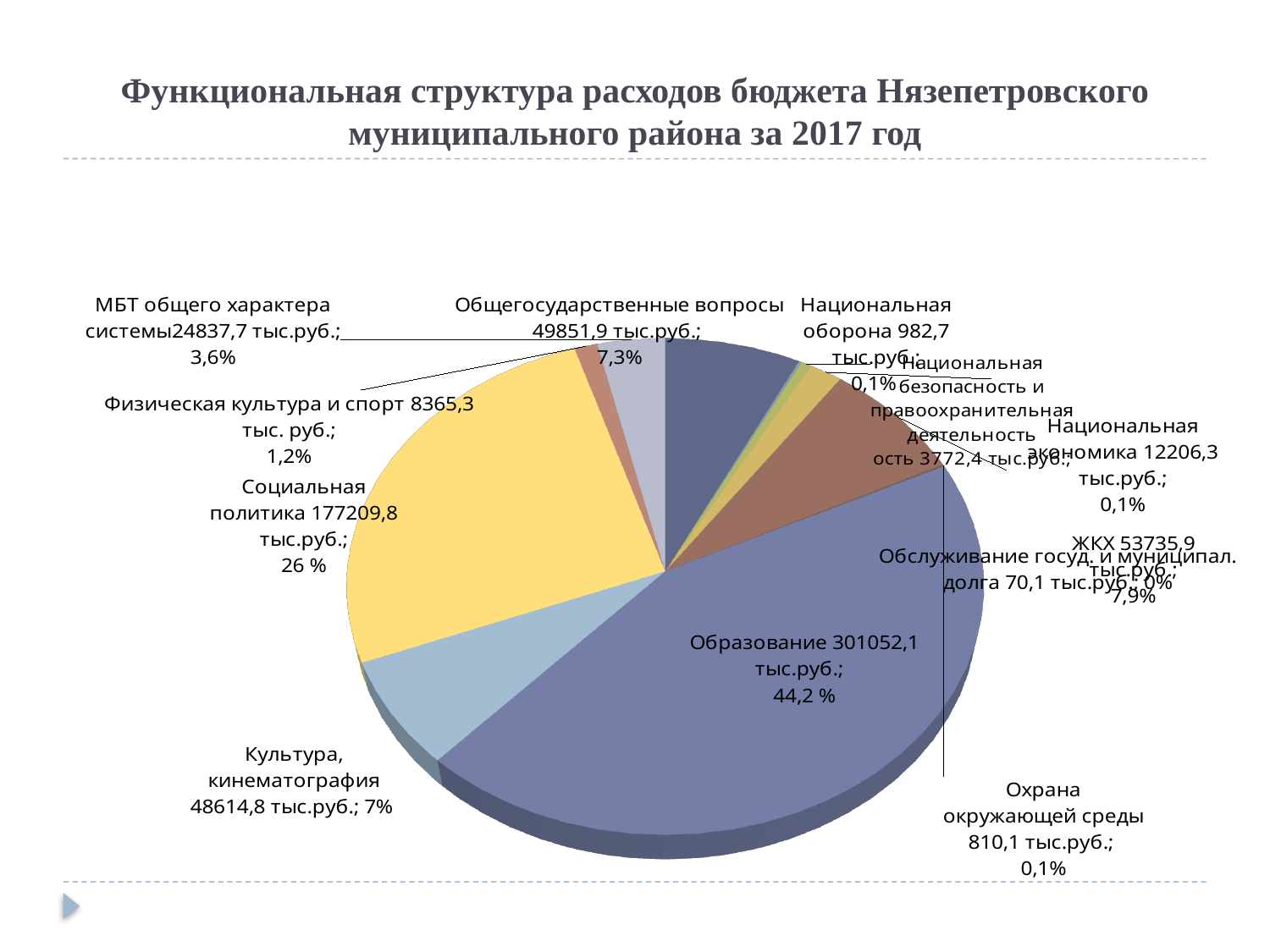
What kind of chart is shown on the slide? pie chart Which category has the largest share of the pie? Образование What is the value shown for Социальная политика? 177209,8 тыс.руб. How many categories does the pie chart show? 12 What is the value shown for Культура, кинематография? 48614,8 тыс.руб. Which is larger, ЖКХ or Общегосударственные вопросы? ЖКХ What share of the pie does Образование account for? 44,2 % What is the title of the slide? Функциональная структура расходов бюджета Нязепетровского муниципального района за 2017 год What is the value shown for ЖКХ? 53735,9 тыс.руб. What is the difference between the values for Образование and Социальная политика? 123842,3 тыс.руб. Which category has the smallest value in the pie? Обслуживание госуд. и муниципал. долга What share of the pie does Социальная политика account for? 26 %